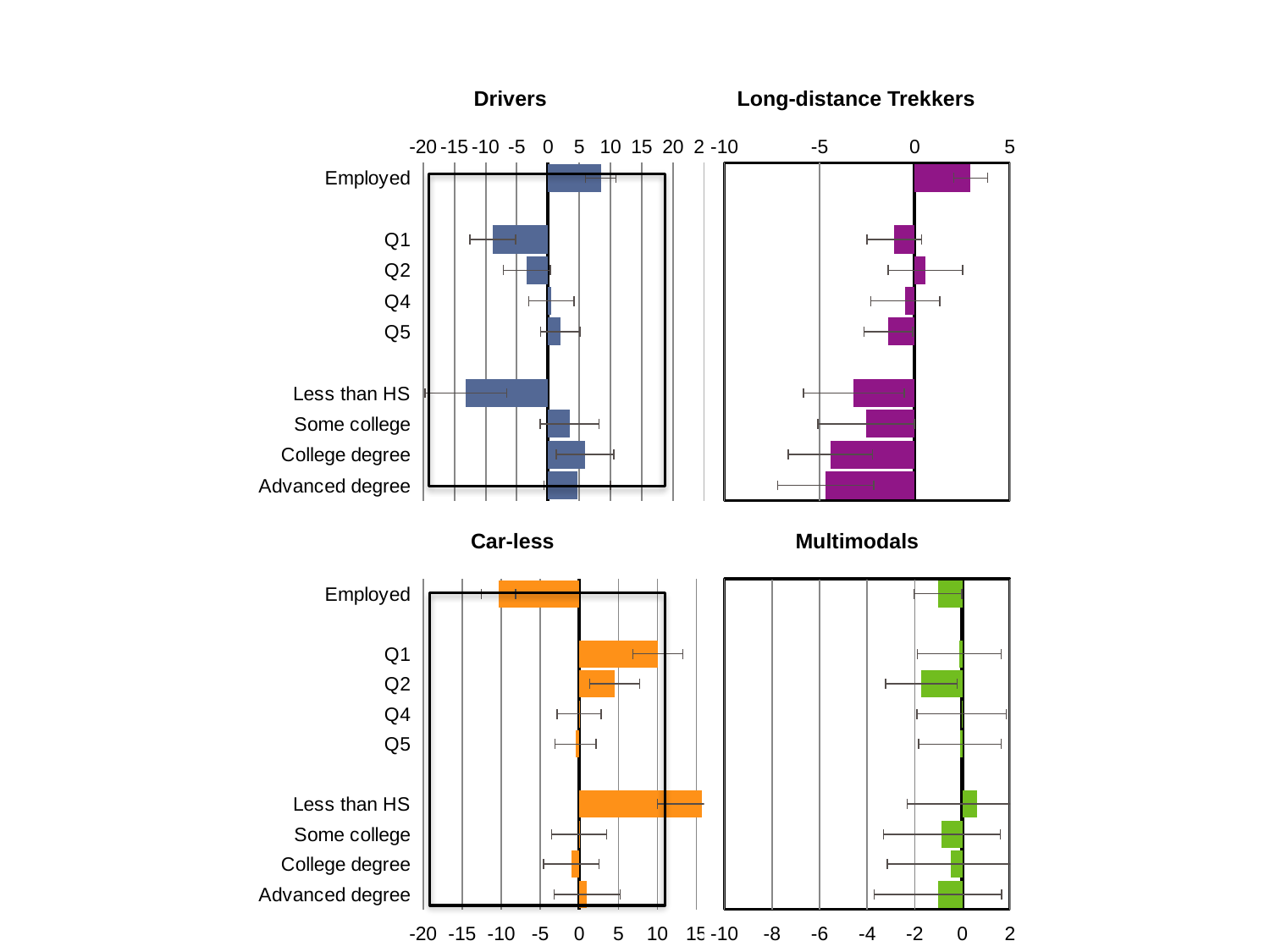
In the Car-less chart, which is larger, the value for Q1 or the value for Q2? Q1 In the Drivers chart, which category has the lowest value? Less than HS In the Long-distance Trekkers chart, which category has the highest value? Employed In the Multimodals chart, which category has the lowest value? Q2 In the Car-less chart, is the value for Less than HS greater or less than 10? greater In the Car-less chart, which category has the highest value? Less than HS In the Drivers chart, which category has the highest value? Employed In the Car-less chart, which category has the lowest value? Employed What colour are the bars in the Multimodals chart? green What kind of chart is the Drivers chart? bar chart In the Drivers chart, is the value for Less than HS greater or less than -10? less How many categories are plotted in the Car-less chart? 9